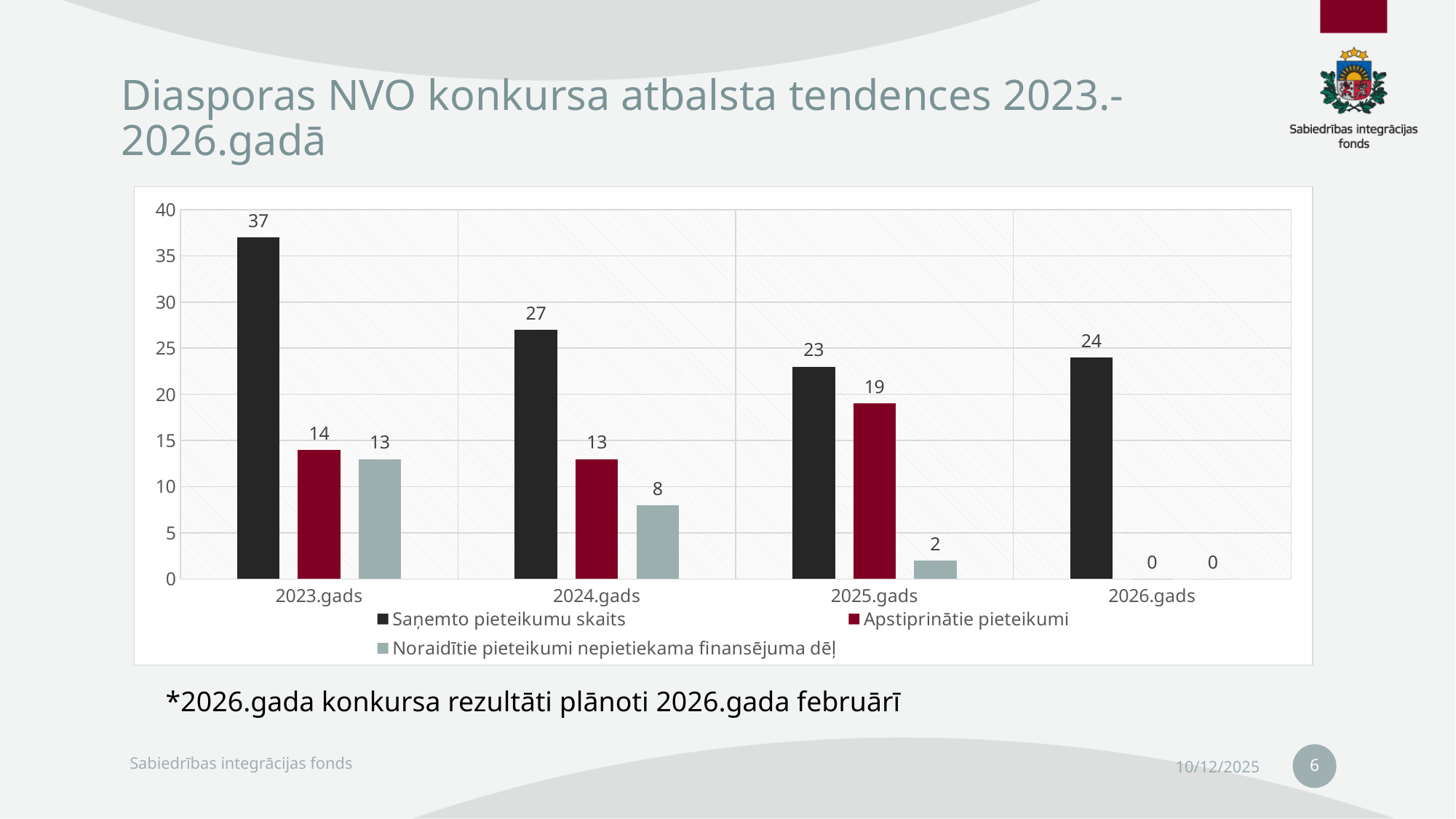
Is the value of Saņemto pieteikumu skaits for 2026.gads greater or less than 20? greater Which is larger for 2025.gads: Apstiprinātie pieteikumi or Noraidītie pieteikumi nepietiekama finansējuma dēļ? Apstiprinātie pieteikumi What is the value of Saņemto pieteikumu skaits for 2023.gads? 37 What kind of chart is shown on the slide? Bar chart What is the difference between Saņemto pieteikumu skaits and Apstiprinātie pieteikumi for 2024.gads? 14 How many series does the legend list? 3 Does Noraidītie pieteikumi nepietiekama finansējuma dēļ rise or fall from 2023.gads to 2026.gads? Fall What is the value of Apstiprinātie pieteikumi for 2025.gads? 19 What is the value of Noraidītie pieteikumi nepietiekama finansējuma dēļ for 2024.gads? 8 Which year has the highest value for Saņemto pieteikumu skaits? 2023.gads Which year has the lowest value for Apstiprinātie pieteikumi? 2026.gads How many years are shown on the x axis? 4